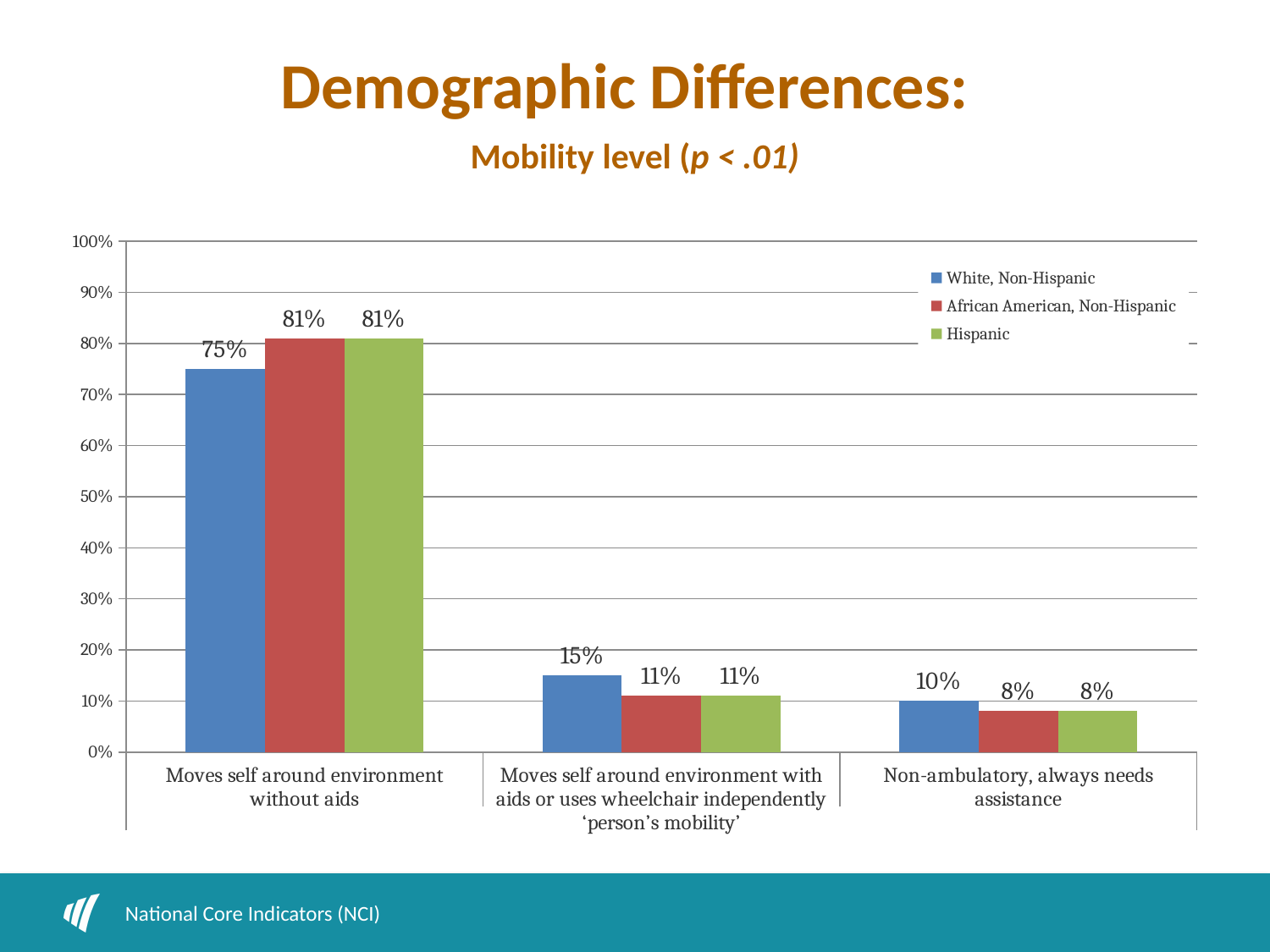
What is the difference between the African American, Non-Hispanic and White, Non-Hispanic values in the 'Moves self around environment without aids' category? 6% Is the value for White, Non-Hispanic in the 'Moves self around environment with aids or uses wheelchair independently' category greater or less than 20%? less Which category has the lowest value for the Hispanic series? Non-ambulatory, always needs assistance What is the value for African American, Non-Hispanic in the 'Moves self around environment with aids or uses wheelchair independently' category? 11% Which category has the highest value for the White, Non-Hispanic series? Moves self around environment without aids Which series is shown in red in the legend? African American, Non-Hispanic In the 'Non-ambulatory, always needs assistance' category, which is larger: the White, Non-Hispanic value or the African American, Non-Hispanic value? White, Non-Hispanic How many series does the legend list? 3 What is the value for White, Non-Hispanic in the 'Moves self around environment without aids' category? 75% What is the value for Hispanic in the 'Non-ambulatory, always needs assistance' category? 8% How many categories are shown on the x axis? 3 What kind of chart is shown on the slide? bar chart